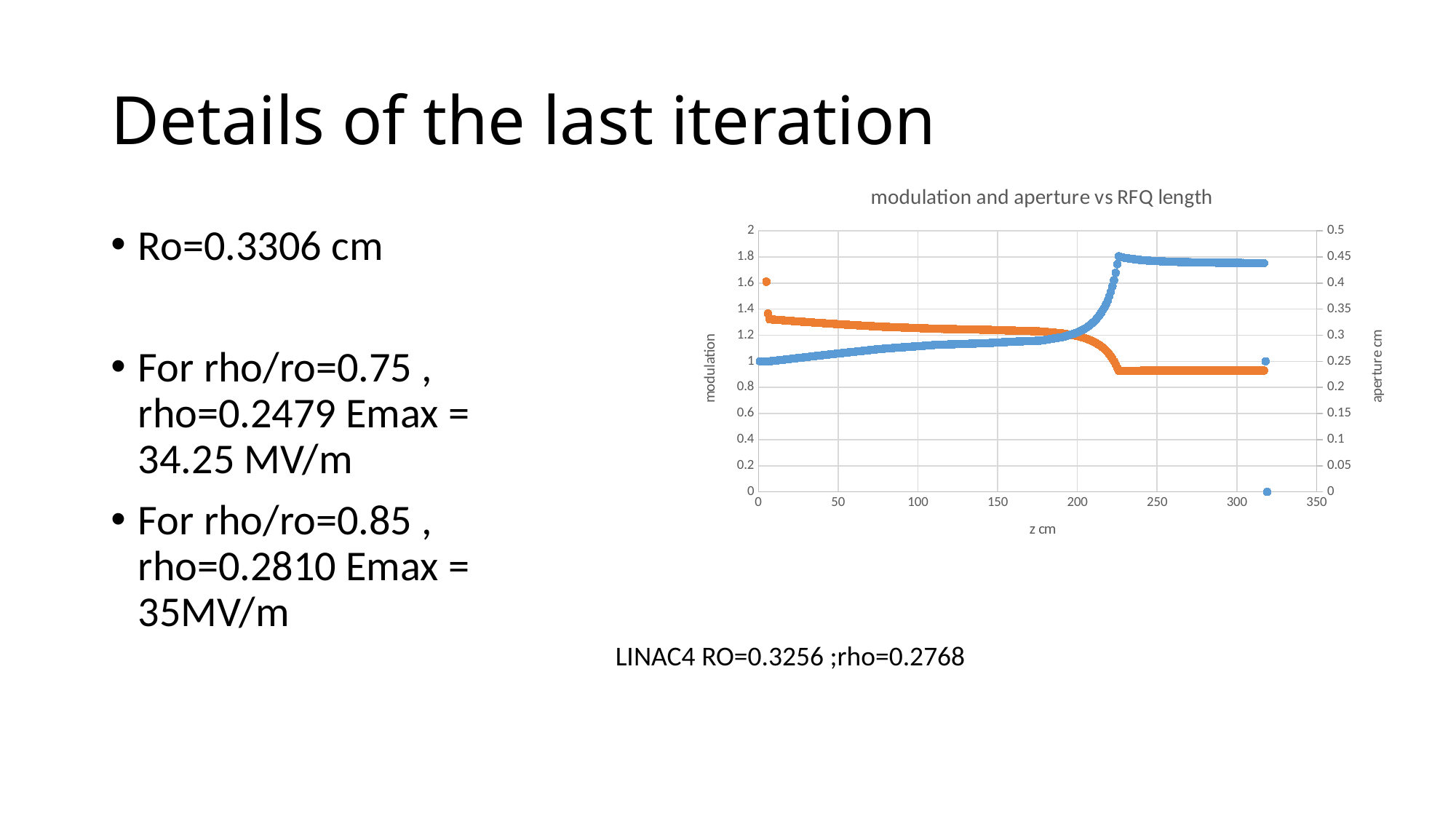
On the left axis, is the value of the blue series at z = 150 greater or less than 1.4? greater Does the orange series rise or fall as z increases along the x axis? falls What is the label of the x axis of the chart? z cm On the right axis, is the value of the orange series at z = 300 greater or less than 0.3? less Around z = 300, which series is plotted higher on the chart, the blue series or the orange series? the blue series What kind of chart is shown on the slide? scatter chart Does the blue series rise or fall as z increases along the x axis? rises On the left axis, is the value of the blue series at z = 50 greater or less than 1.2? less What is the title of the chart? modulation and aperture vs RFQ length